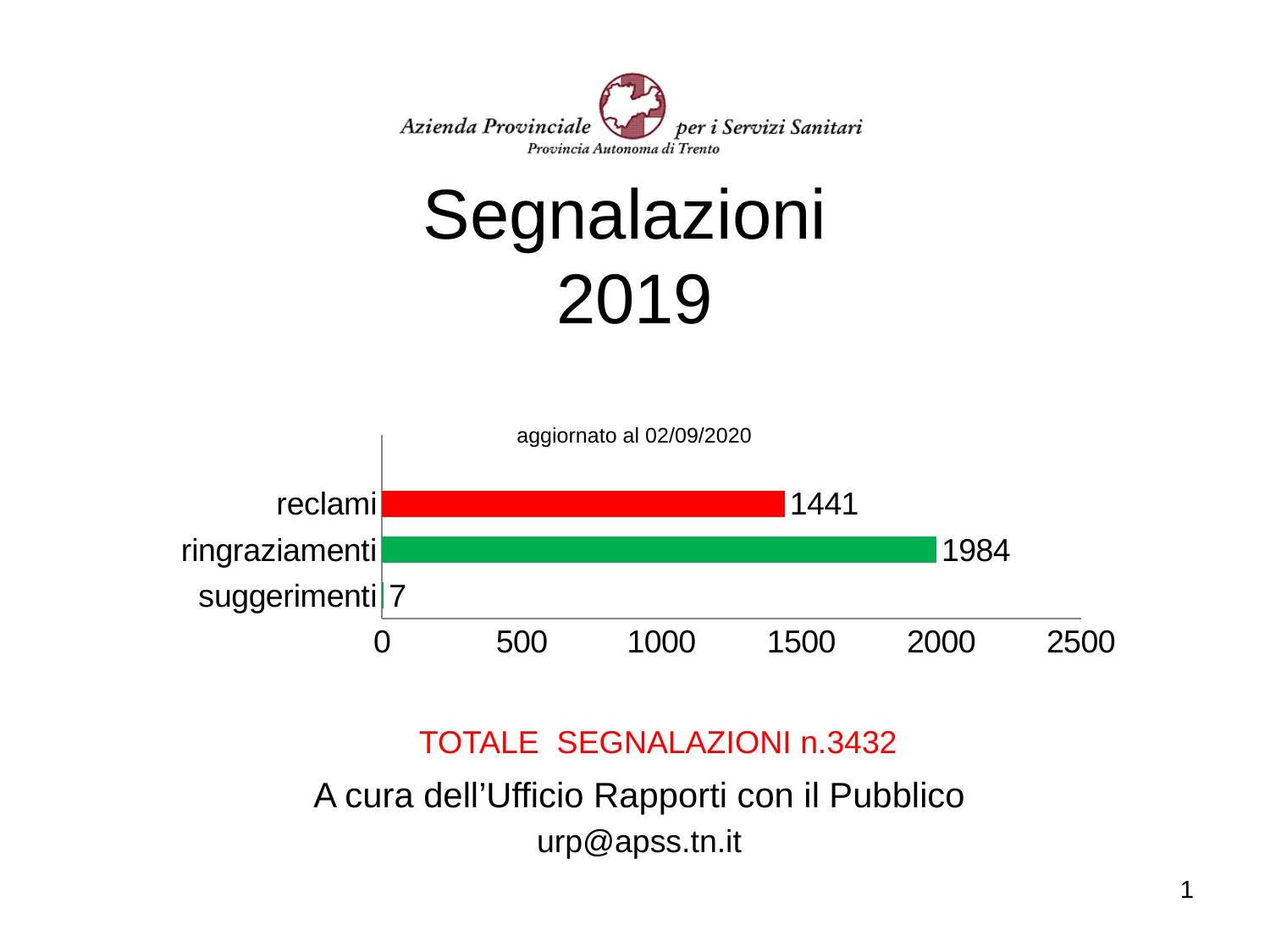
What is the value for ringraziamenti? 1984 How many categories are shown in the chart? 3 What is the difference between ringraziamenti and reclami? 543 Which category has the lowest value? suggerimenti Which is larger, reclami or ringraziamenti? ringraziamenti What is the value for suggerimenti? 7 Which category has the highest value? ringraziamenti What kind of chart is shown on the slide? bar chart What colour is the bar for ringraziamenti? green What is the value for reclami? 1441 Is the value for reclami greater or less than 1500? less